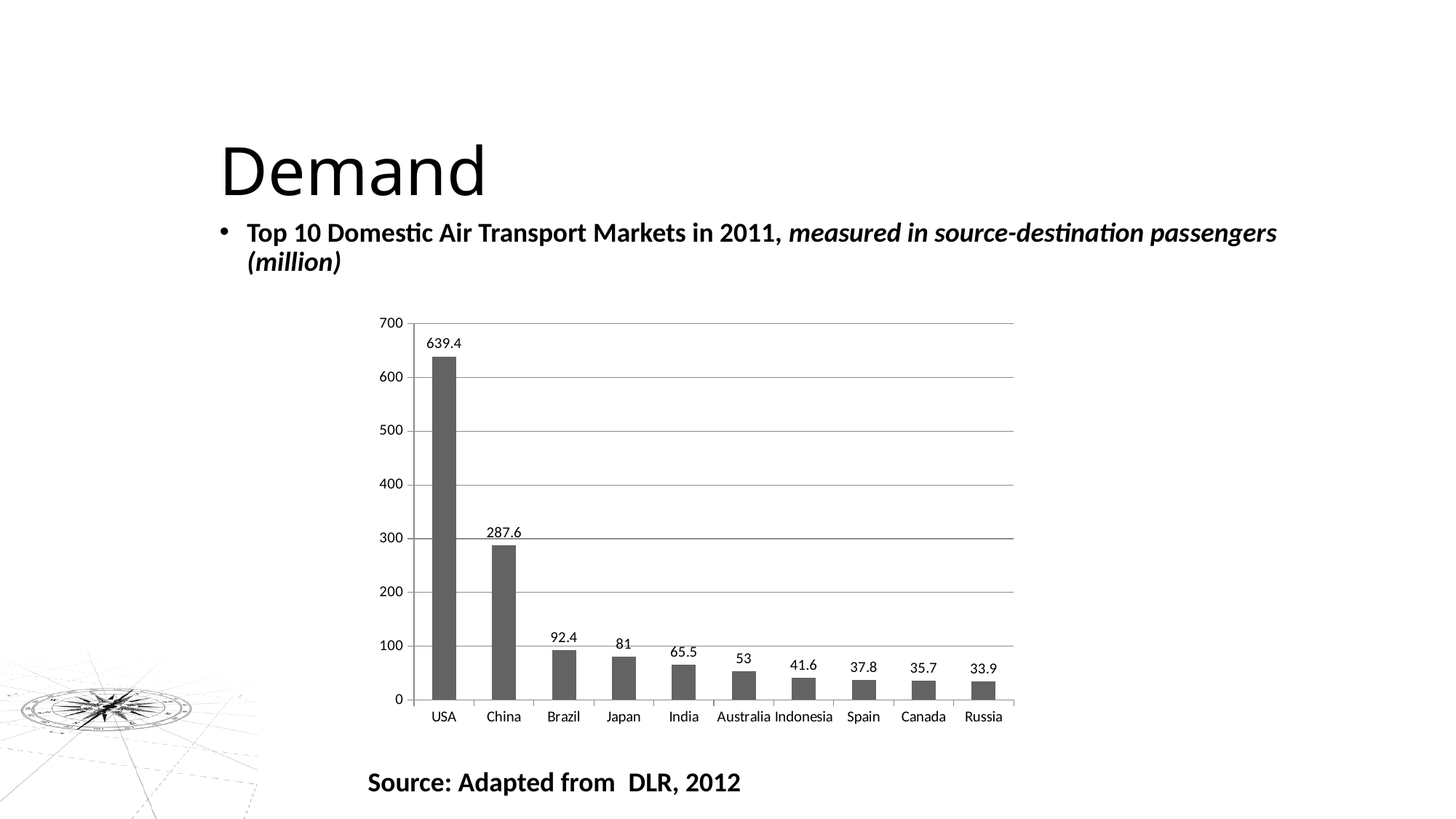
Do the values rise or fall from left to right along the x axis? Fall Which is larger, the value for India or the value for Australia? India What is the value for Indonesia? 41.6 How many countries are shown in the chart? 10 What kind of chart is shown on the slide? Bar chart Which country has the lowest value? Russia Which country has the highest value? USA What is the value for Russia? 33.9 What is the difference between the values for Brazil and Japan? 11.4 What is the value for China? 287.6 What is the value for USA? 639.4 What is the difference between the values for USA and China? 351.8